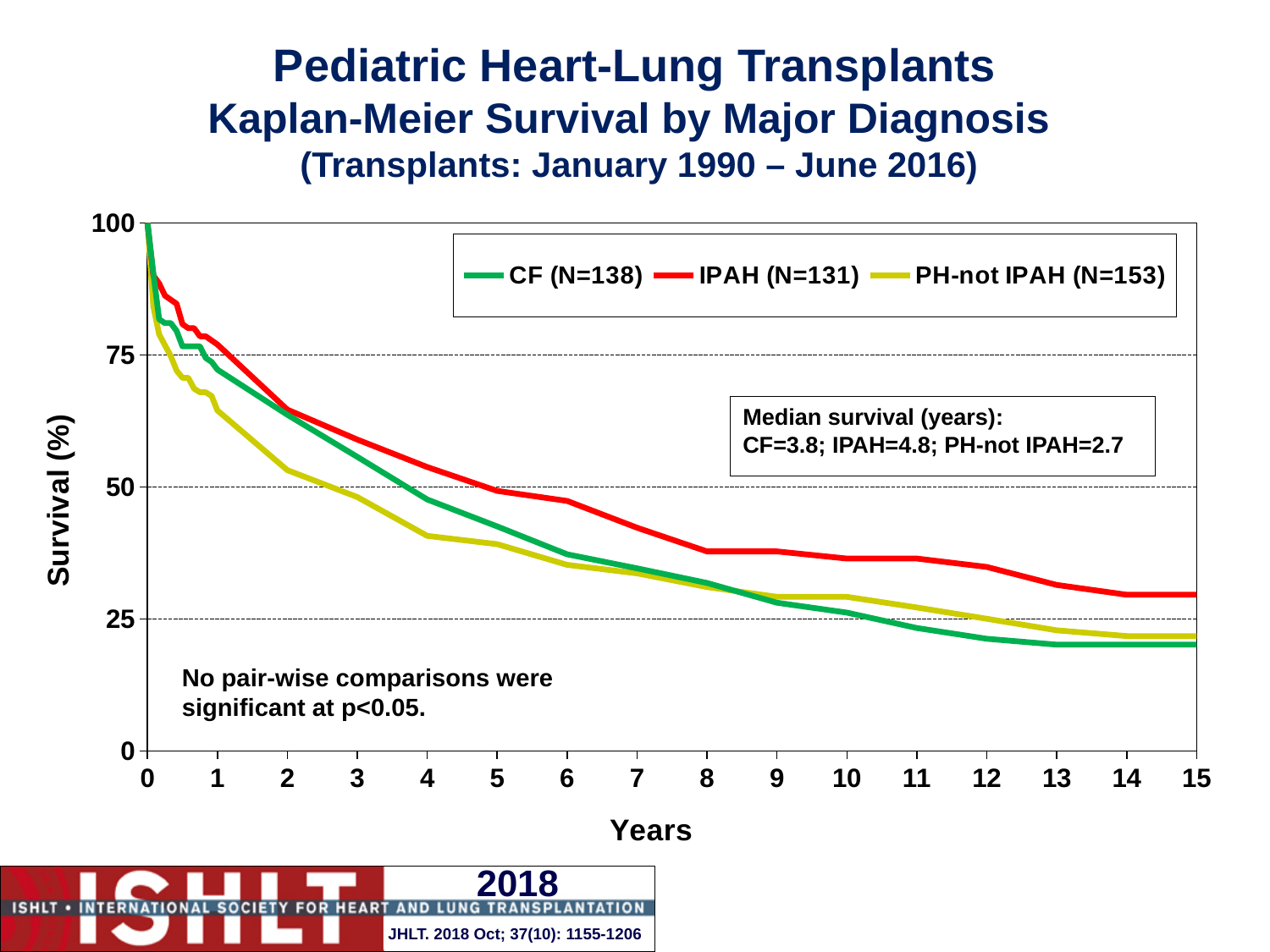
At 15 years, which curve shows higher survival, IPAH or CF? IPAH Which diagnosis group has the highest median survival? IPAH How many series does the legend list? 3 What is the N for the CF group shown in the legend? 138 Which diagnosis group has the lowest median survival? PH-not IPAH Do the survival curves rise or fall as years increase along the x axis? Fall Is the survival for CF at 5 years greater or less than 50? less What is the median survival in years for PH-not IPAH, as stated in the text box on the chart? 2.7 What is the median survival in years for IPAH, as stated in the text box on the chart? 4.8 Is the survival for IPAH at 15 years greater or less than 25? greater What is the difference in median survival (years) between IPAH and CF? 1.0 What kind of chart is shown on the slide? Line chart